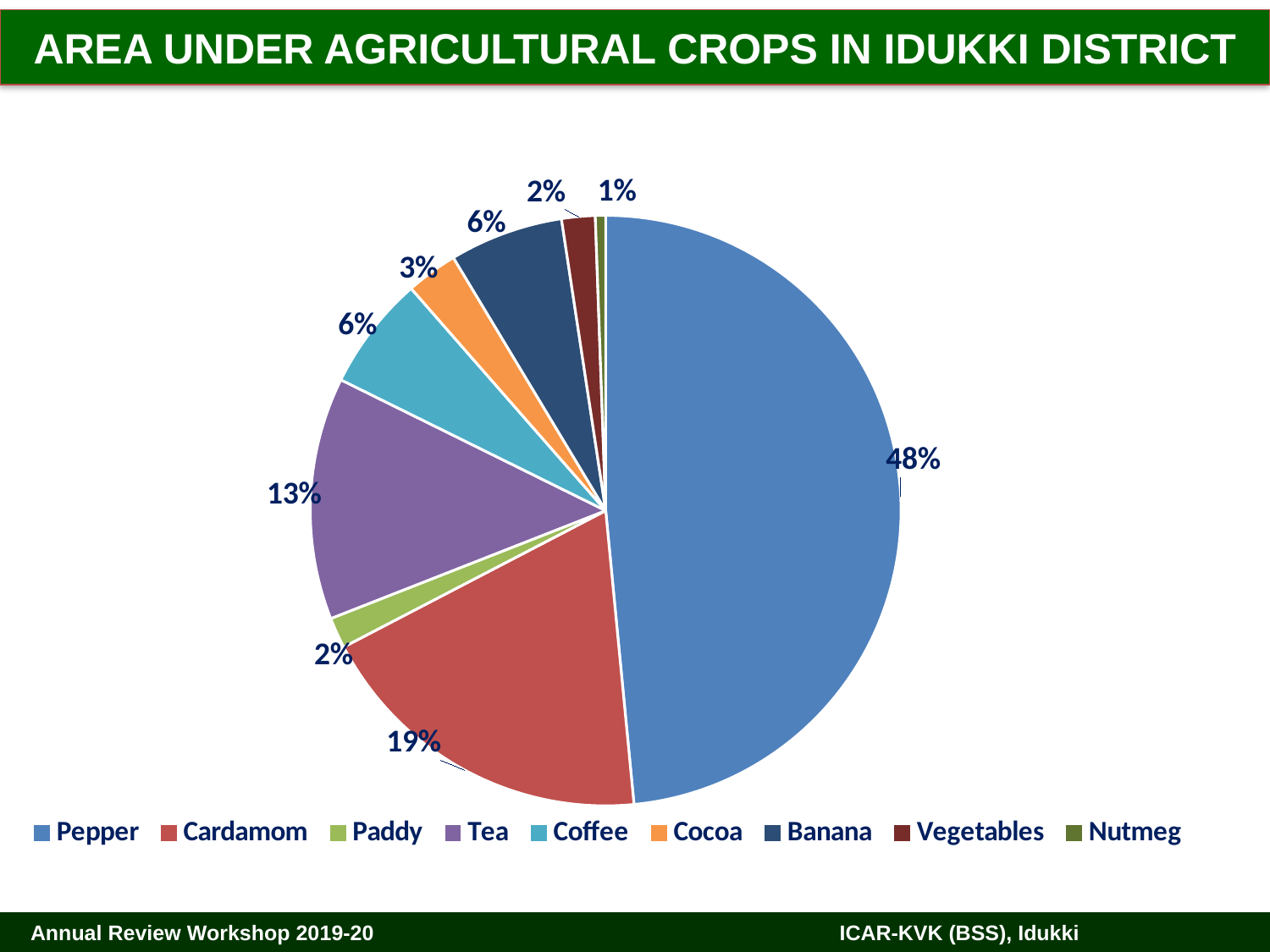
What share of the area is Cardamom? 19% How many crops are listed in the legend? 9 Which has a larger share, Tea or Coffee? Tea What share of the area is Tea? 13% Which crop has the largest share of the area? Pepper What colour is the Cardamom slice? Red What share of the area under agricultural crops is Pepper? 48% What type of chart is shown on the slide? Pie chart What is the title of the chart? AREA UNDER AGRICULTURAL CROPS IN IDUKKI DISTRICT Which crop has the smallest share of the area? Nutmeg What is the difference in percentage points between the Pepper and Cardamom shares? 29